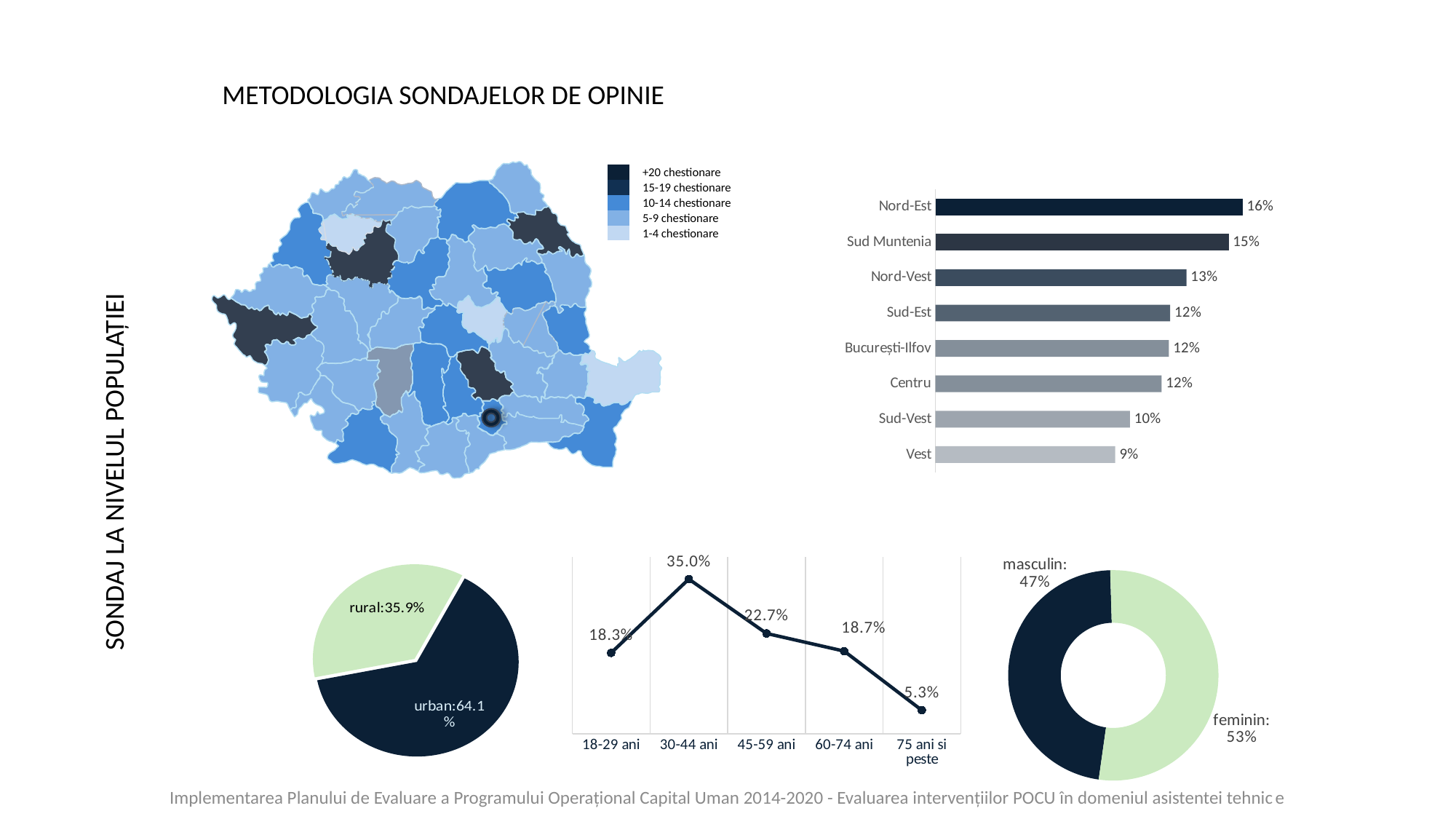
In the pie chart at the bottom left, which slice is larger, urban or rural? urban In the horizontal bar chart at the top right, which region has the highest value? Nord-Est In the donut chart at the bottom right, what is the share for feminin? 53% In the line chart at the bottom centre, what is the value for the 30-44 ani age group? 35.0% In the horizontal bar chart at the top right, what is the value for Nord-Est? 16% In the line chart at the bottom centre, which age group has the lowest value? 75 ani si peste In the horizontal bar chart at the top right, which is larger, Nord-Vest or Centru? Nord-Vest In the line chart at the bottom centre, what is the difference between the 45-59 ani and 60-74 ani values? 4.0% In the horizontal bar chart at the top right, how many regions are shown? 8 In the horizontal bar chart at the top right, what is the difference between Sud Muntenia and Sud-Vest? 5% In the horizontal bar chart at the top right, which region has the lowest value? Vest In the pie chart at the bottom left, what is the share for rural? 35.9%